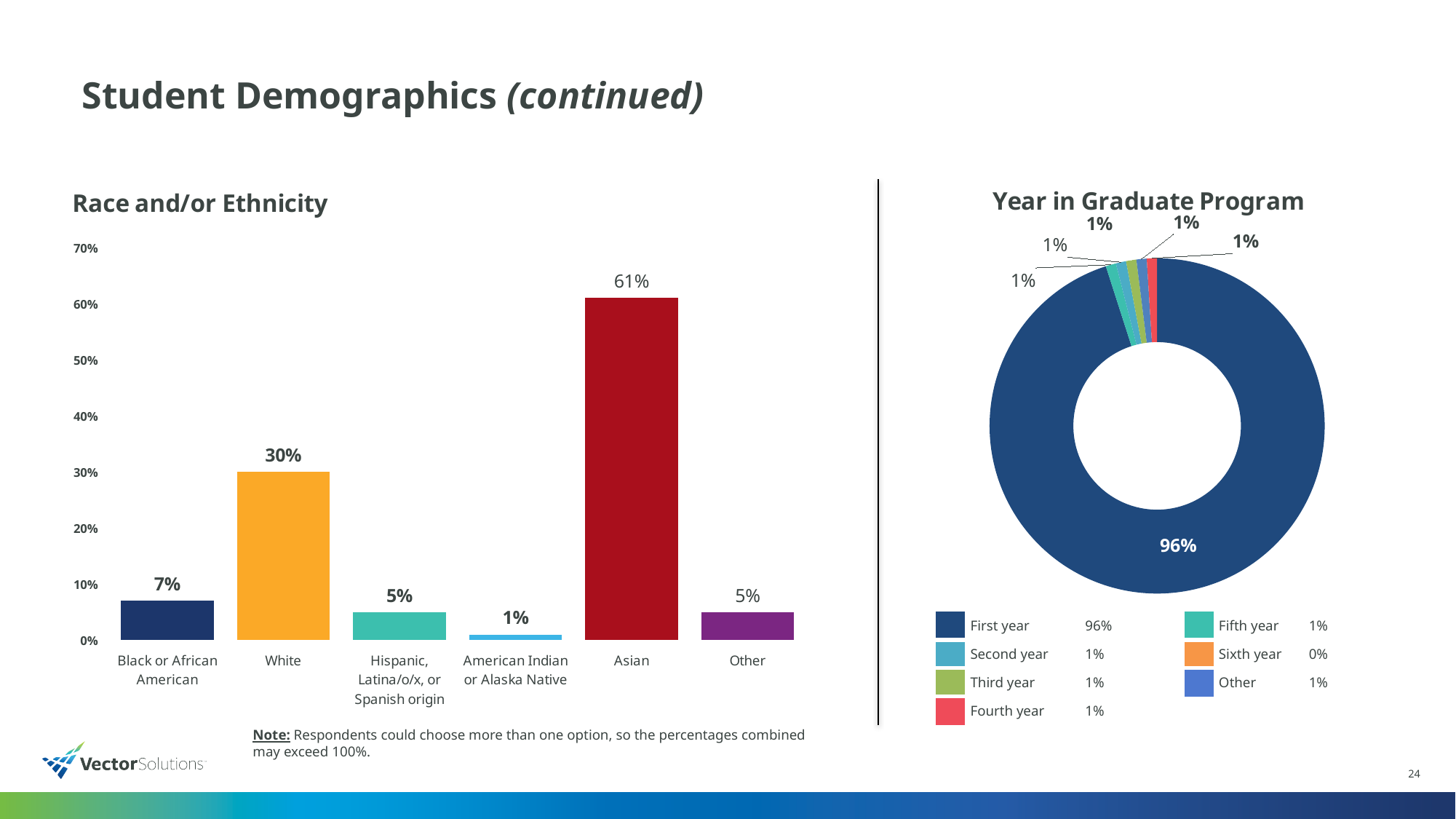
What kind of chart is the Year in Graduate Program chart? Doughnut chart In the Race and/or Ethnicity chart, what percentage is shown for White? 30% In the Year in Graduate Program chart, what share is shown for First year? 96% In the Race and/or Ethnicity chart, what is the difference between the percentages for Asian and White? 31% In the Race and/or Ethnicity chart, which category has the lowest percentage? American Indian or Alaska Native In the Race and/or Ethnicity chart, what percentage is shown for Asian? 61% What kind of chart is the Race and/or Ethnicity chart? Bar chart In the Race and/or Ethnicity chart, which is larger, the value for Black or African American or the value for Other? Black or African American In the Race and/or Ethnicity chart, which category has the highest percentage? Asian In the Year in Graduate Program chart, what percentage is listed for Sixth year? 0% How many categories are shown in the Race and/or Ethnicity chart? 6 How many entries does the legend of the Year in Graduate Program chart list? 7